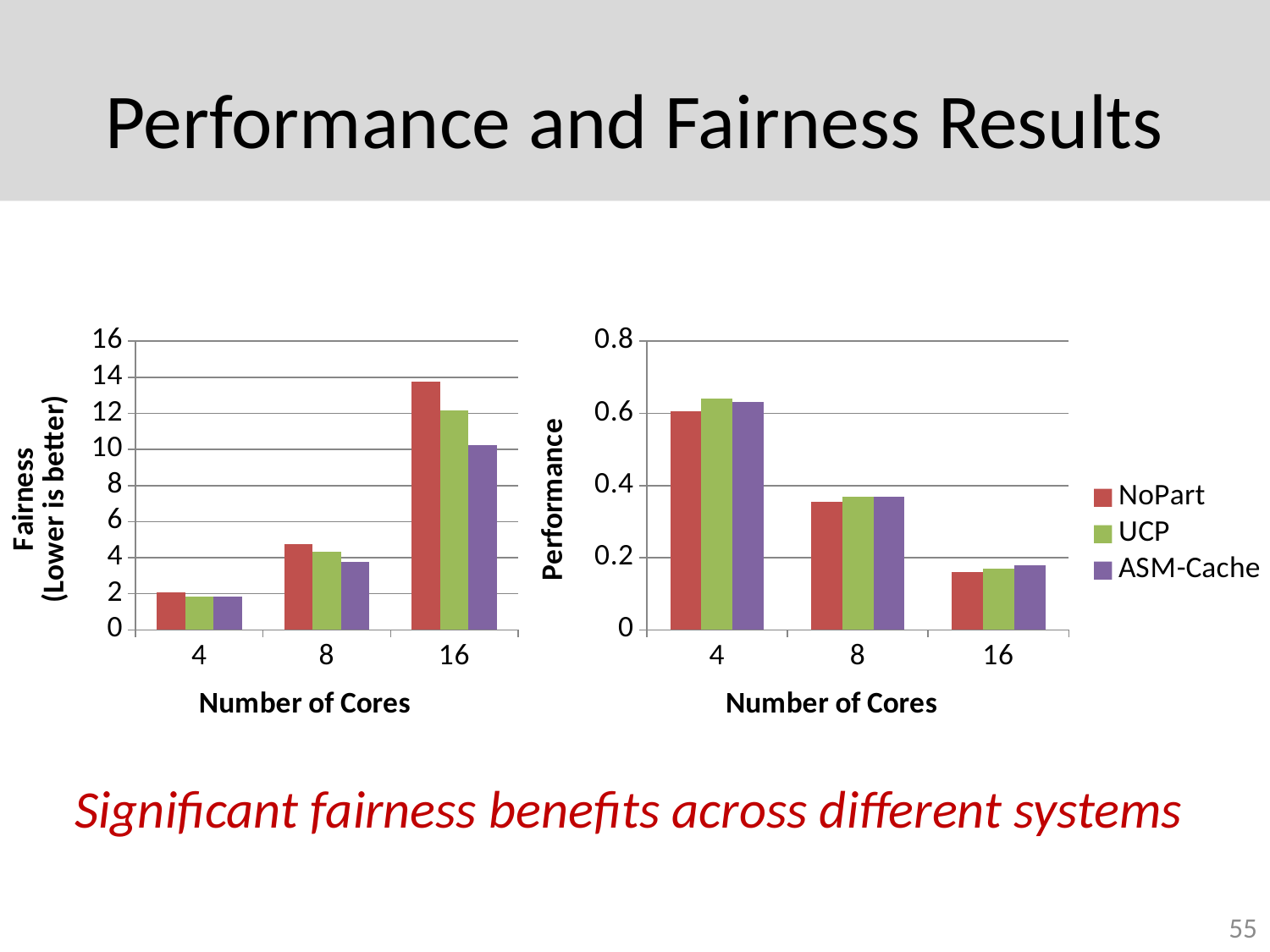
In the left chart (Fairness), is the ASM-Cache value at 16 cores greater or less than 12? less In the left chart (Fairness), at which number of cores is the NoPart value highest? 16 In the left chart (Fairness), how many core counts are shown on the x axis? 3 In the right chart (Performance), is the NoPart value at 4 cores greater or less than 0.4? greater What kind of chart is the left chart (Fairness)? bar chart In the right chart (Performance), at which number of cores is the UCP value lowest? 16 In the left chart (Fairness), do the NoPart values rise or fall as the number of cores increases? rise In the left chart (Fairness), is the NoPart value at 16 cores greater or less than 12? greater In the left chart (Fairness), which series has the lowest value at 16 cores? ASM-Cache How many series does the legend list? 3 What is the y-axis label of the left chart? Fairness (Lower is better) In the right chart (Performance), do the NoPart values rise or fall as the number of cores increases? fall